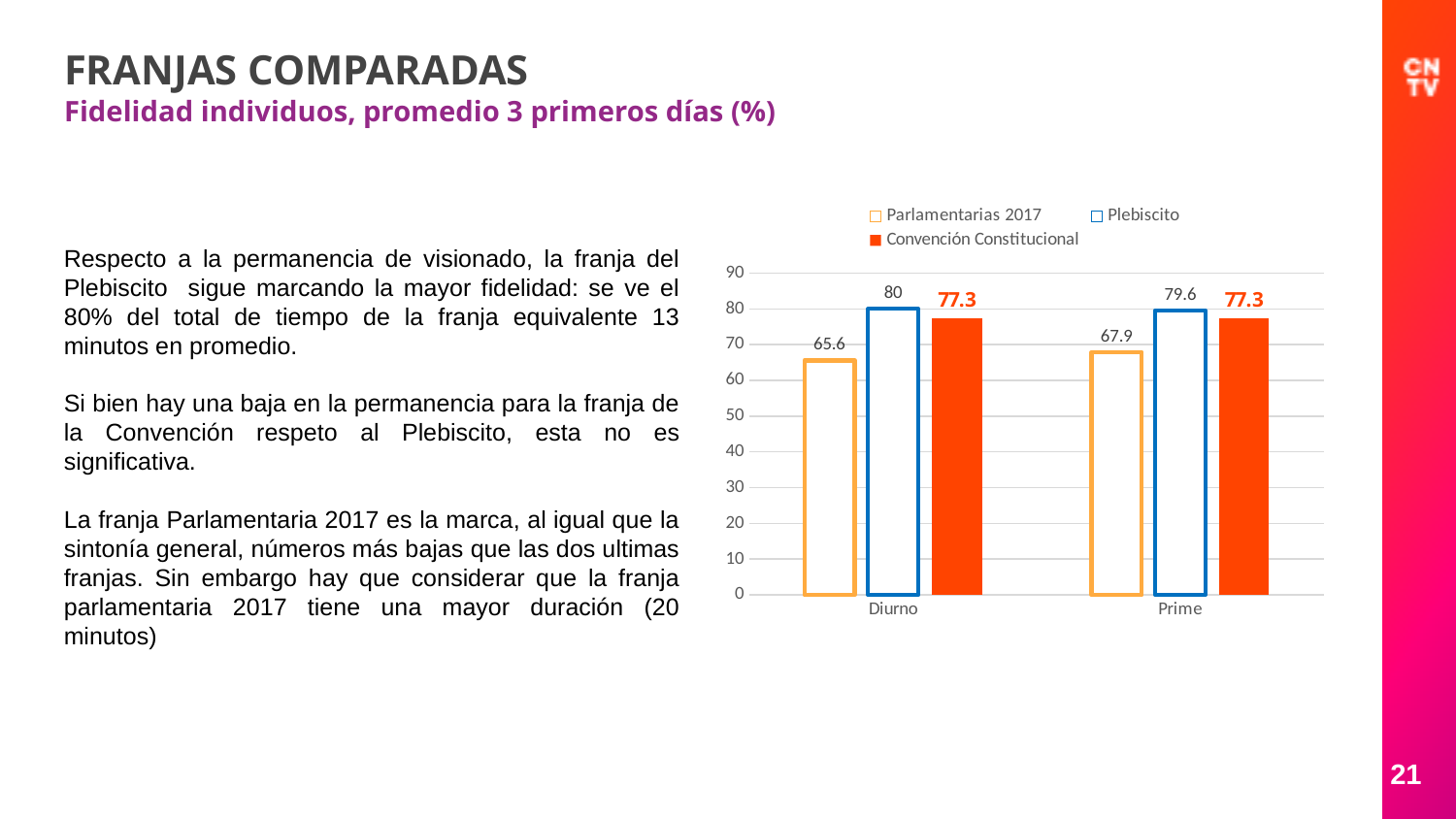
What is the value for Plebiscito in the Prime category? 79.6 Is the value for Parlamentarias 2017 in the Prime category greater or less than 70? less How many series does the legend list? 3 What kind of chart is shown on the slide? bar chart How many categories are shown on the x axis? 2 What is the difference between the Plebiscito and Parlamentarias 2017 values in the Diurno category? 14.4 Which series has the lowest value in the Prime category? Parlamentarias 2017 What is the difference between the Plebiscito and Convención Constitucional values in the Prime category? 2.3 What is the value for Convención Constitucional in the Diurno category? 77.3 Which series has the highest value in the Diurno category? Plebiscito What is the value for Parlamentarias 2017 in the Diurno category? 65.6 Which is larger: the Parlamentarias 2017 value for Diurno or for Prime? Prime